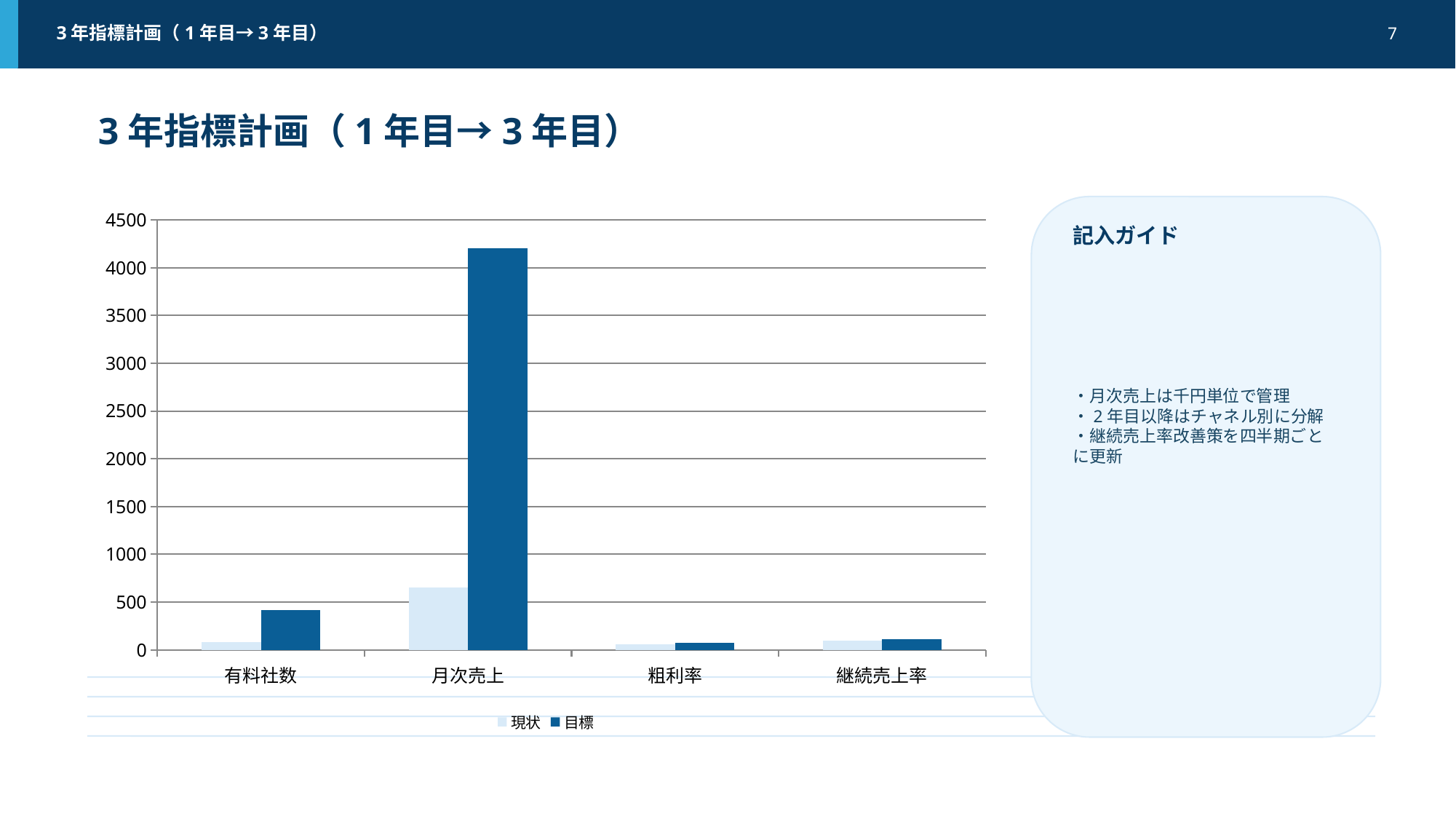
Is the 目標 value for 有料社数 greater or less than 500? less For 月次売上, which is larger, the 現状 value or the 目標 value? 目標 Which is larger, the 目標 value for 有料社数 or the 目標 value for 継続売上率? 有料社数 How many categories are shown on the x axis of the chart? 4 What kind of chart is shown on the slide? bar chart What are the two series names listed in the chart legend? 現状, 目標 How many series does the chart legend list? 2 Which category has the highest 現状 value? 月次売上 Is the 現状 value for 月次売上 greater or less than 1000? less Is the 目標 value for 月次売上 greater or less than 4000? greater Which category has the highest 目標 value? 月次売上